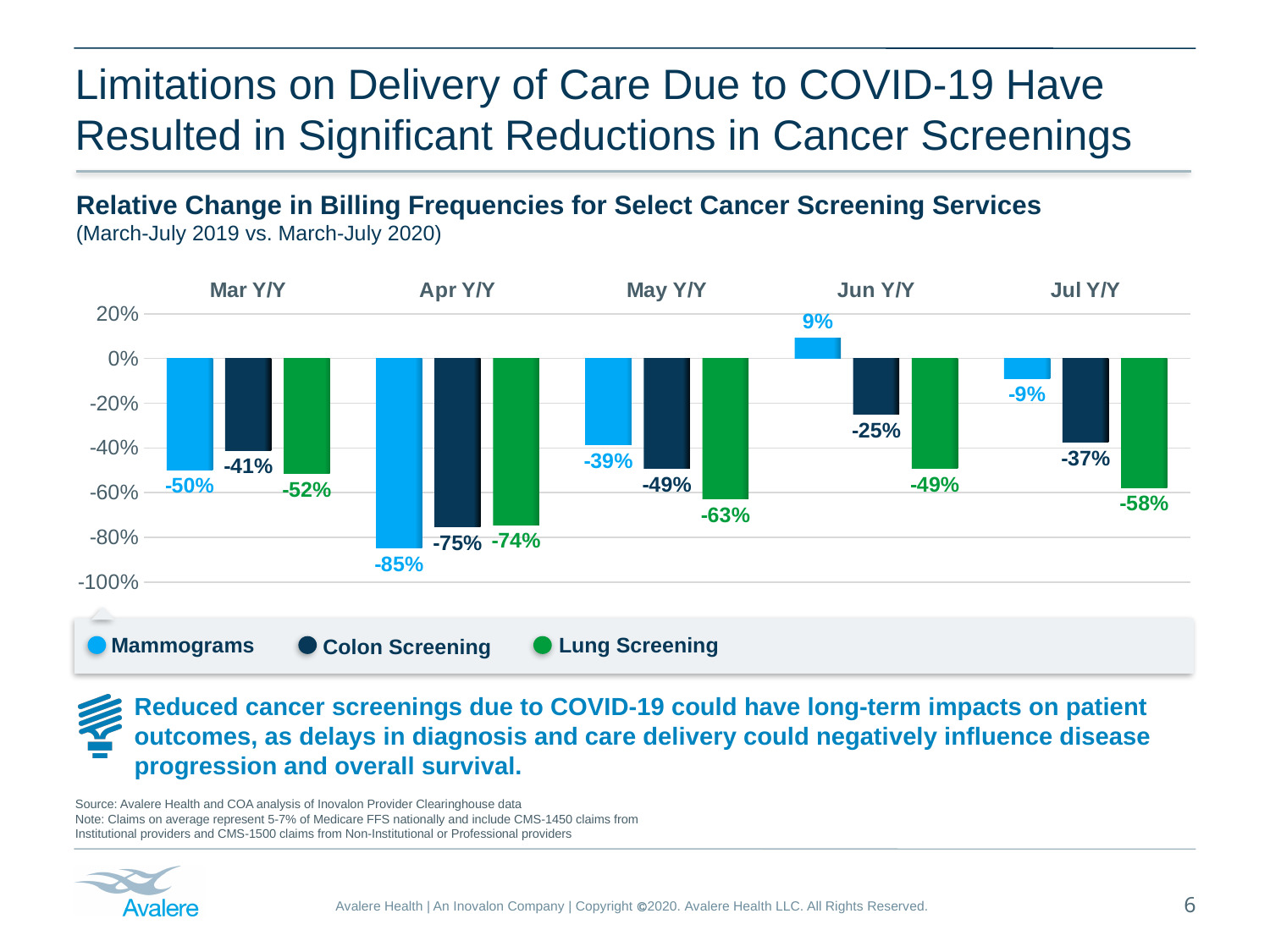
What is the value for Mammograms in Jun Y/Y? 9% What is the difference between the Mammograms value and the Colon Screening value in Apr Y/Y? 10 percentage points What is the value for Mammograms in Apr Y/Y? -85% In which month does Mammograms have its highest value? Jun Y/Y How many months are shown on the x axis? 5 How many series does the legend list? 3 In which month does Lung Screening have its lowest value? Apr Y/Y What kind of chart is shown on the slide? Bar chart Which series is shown in green in the legend? Lung Screening What is the value for Lung Screening in May Y/Y? -63% Which is larger in Jul Y/Y, the value for Colon Screening or the value for Lung Screening? Colon Screening What is the value for Colon Screening in Jun Y/Y? -25%